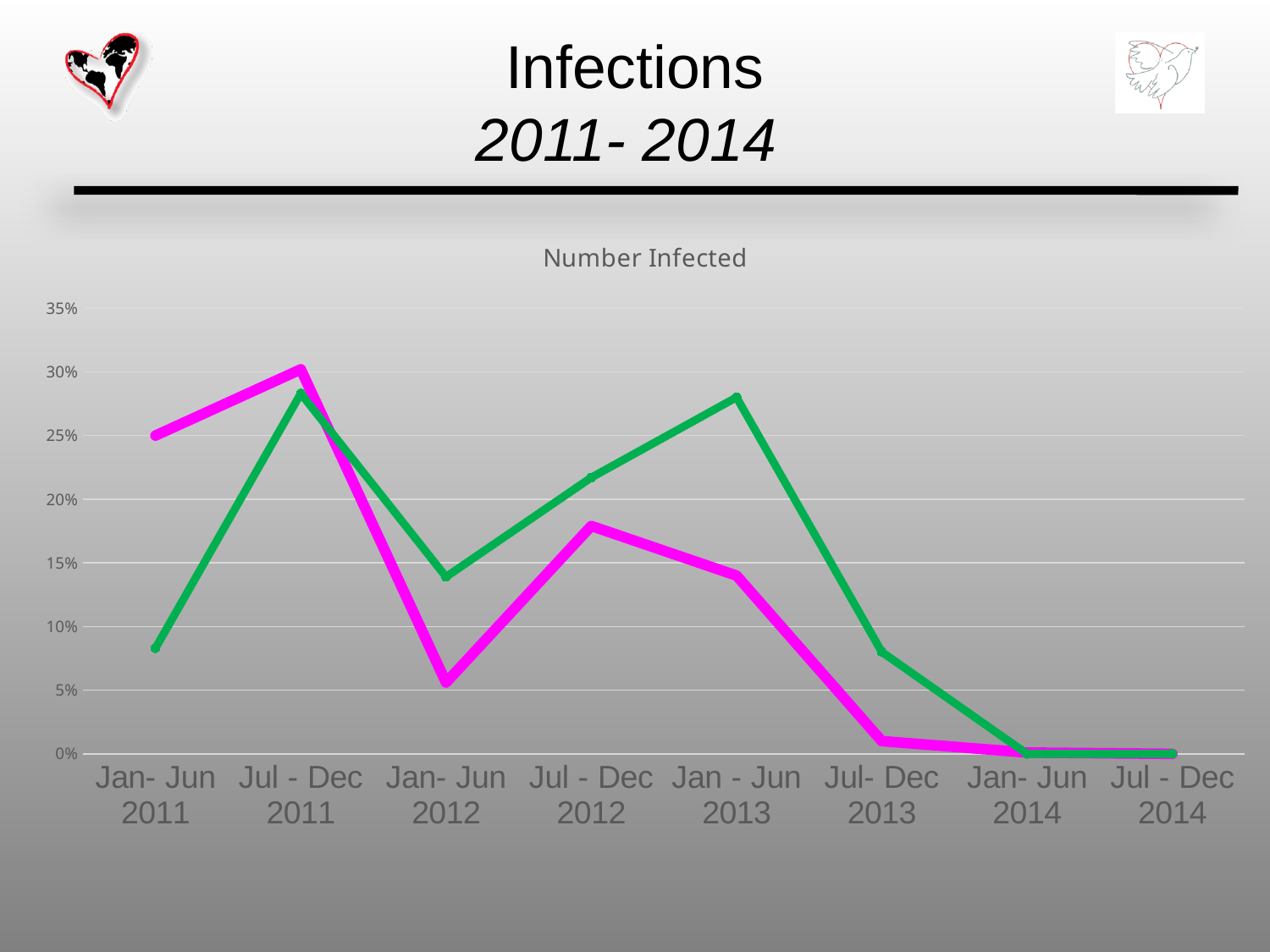
How many time periods are shown along the x axis of the chart? 8 What is the value of the magenta line for Jul - Dec 2014? 0% Is the value of the green line for Jan - Jun 2013 greater or less than 25%? greater Is the value of the magenta line for Jan- Jun 2012 greater or less than 10%? less What is the value of the green line for Jan- Jun 2014? 0% In which period does the magenta line reach its highest value? Jul - Dec 2011 What is the title of the chart? Number Infected How many lines are plotted on the chart? 2 What kind of chart is shown on the slide? line chart Does the magenta line rise or fall from Jan - Jun 2013 to Jul- Dec 2013? fall Is the value of the green line for Jan- Jun 2011 greater or less than 10%? less For Jan - Jun 2013, which line has the higher value, the green line or the magenta line? green line